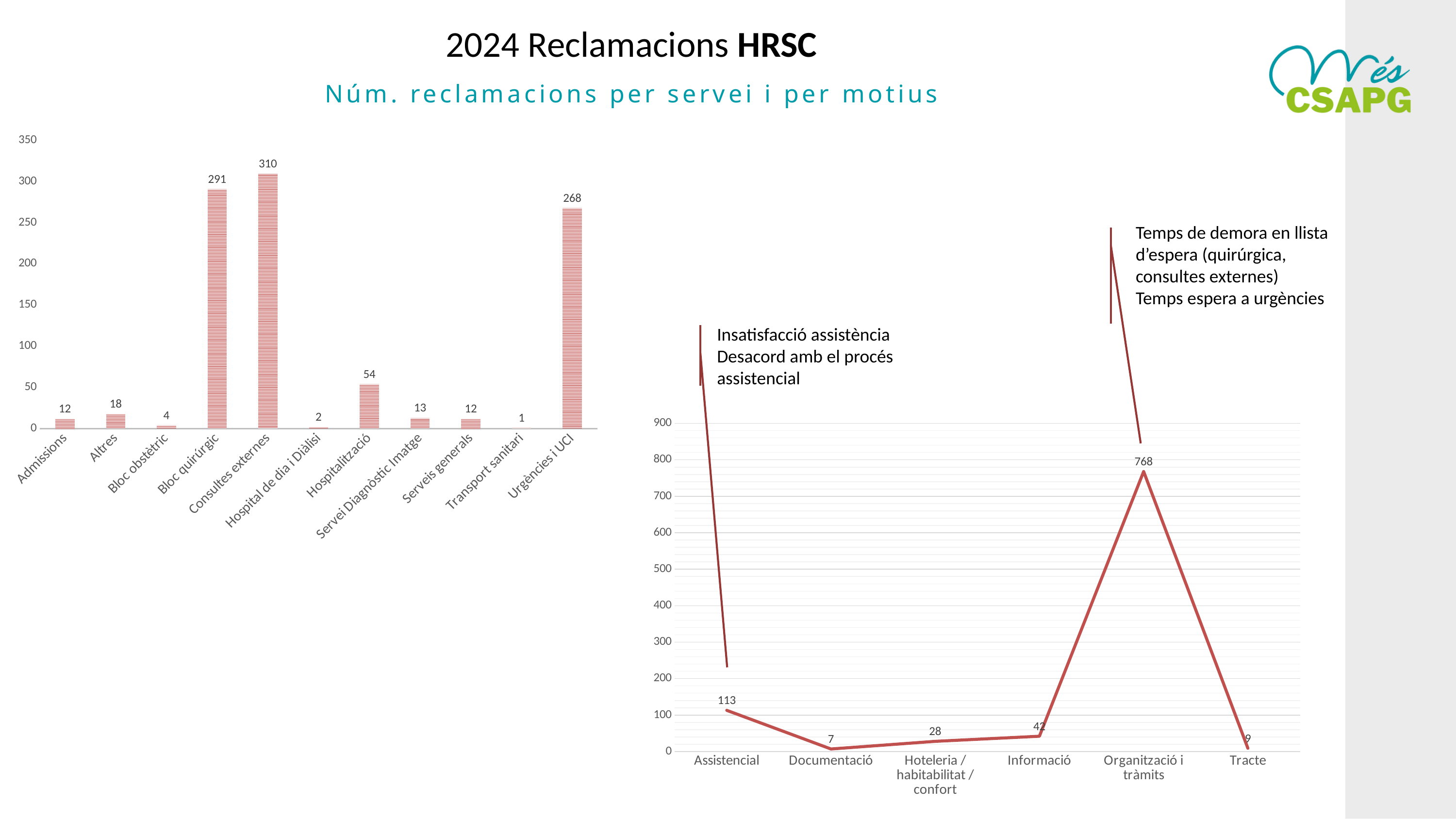
In the line chart on the right, which is larger, Informació or Hoteleria / habitabilitat / confort? Informació In the line chart on the right, what is the value for Organització i tràmits? 768 In the line chart on the right, what is the value for Assistencial? 113 In the bar chart on the left, what is the value for Urgències i UCI? 268 What kind of chart is the chart on the left? Bar chart In the bar chart on the left, what is the difference between Consultes externes and Bloc quirúrgic? 19 In the bar chart on the left, how many categories are shown on the x axis? 11 In the line chart on the right, which category has the lowest value? Documentació In the bar chart on the left, what is the value for Consultes externes? 310 In the bar chart on the left, which category has the lowest value? Transport sanitari In the bar chart on the left, which category has the highest value? Consultes externes In the line chart on the right, how many categories are shown on the x axis? 6